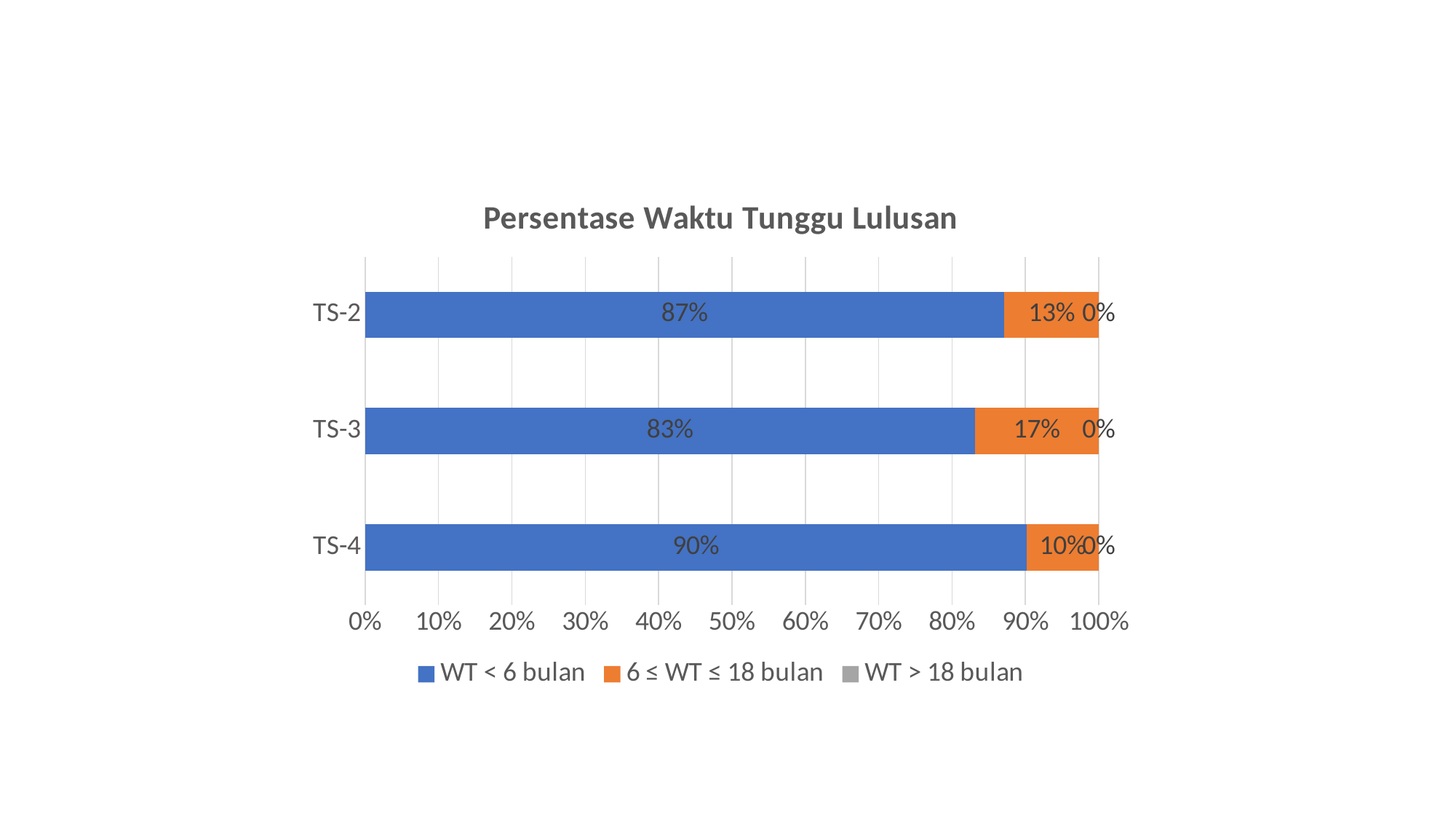
What is the title of the chart? Persentase Waktu Tunggu Lulusan What is the value for 'WT < 6 bulan' for TS-2? 87% What is the value for 'WT < 6 bulan' for TS-4? 90% Which category has the lowest value for 'WT < 6 bulan'? TS-3 What is the value for '6 ≤ WT ≤ 18 bulan' for TS-3? 17% Which is larger, the '6 ≤ WT ≤ 18 bulan' value for TS-2 or for TS-4? TS-2 Which category has the highest value for 'WT < 6 bulan'? TS-4 What is the value for 'WT > 18 bulan' for TS-2? 0% What is the difference between the 'WT < 6 bulan' values for TS-4 and TS-3? 7% What kind of chart is shown on the slide? Stacked bar chart How many series does the legend list? 3 How many categories are shown on the chart? 3